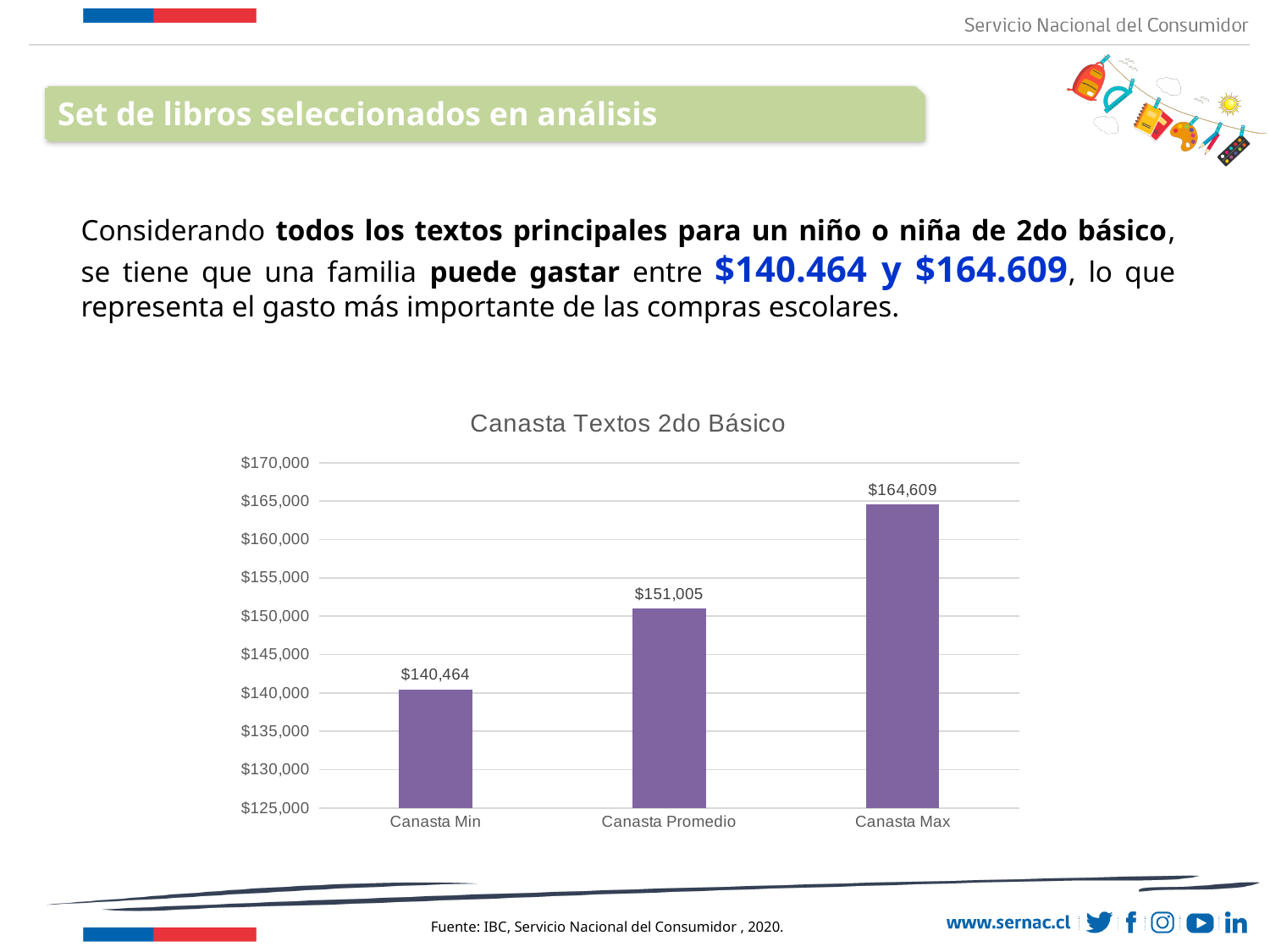
What is the value for Canasta Max? $164,609 Which category has the highest value? Canasta Max What is the difference between Canasta Max and Canasta Min? $24,145 What is the value for Canasta Min? $140,464 Which is larger, Canasta Promedio or Canasta Max? Canasta Max What kind of chart is shown on the slide? Bar chart What is the difference between Canasta Promedio and Canasta Min? $10,541 How many categories are shown in the chart? 3 What is the title of the chart? Canasta Textos 2do Básico What is the value for Canasta Promedio? $151,005 Is the value for Canasta Promedio greater or less than $150,000? greater Which category has the lowest value? Canasta Min